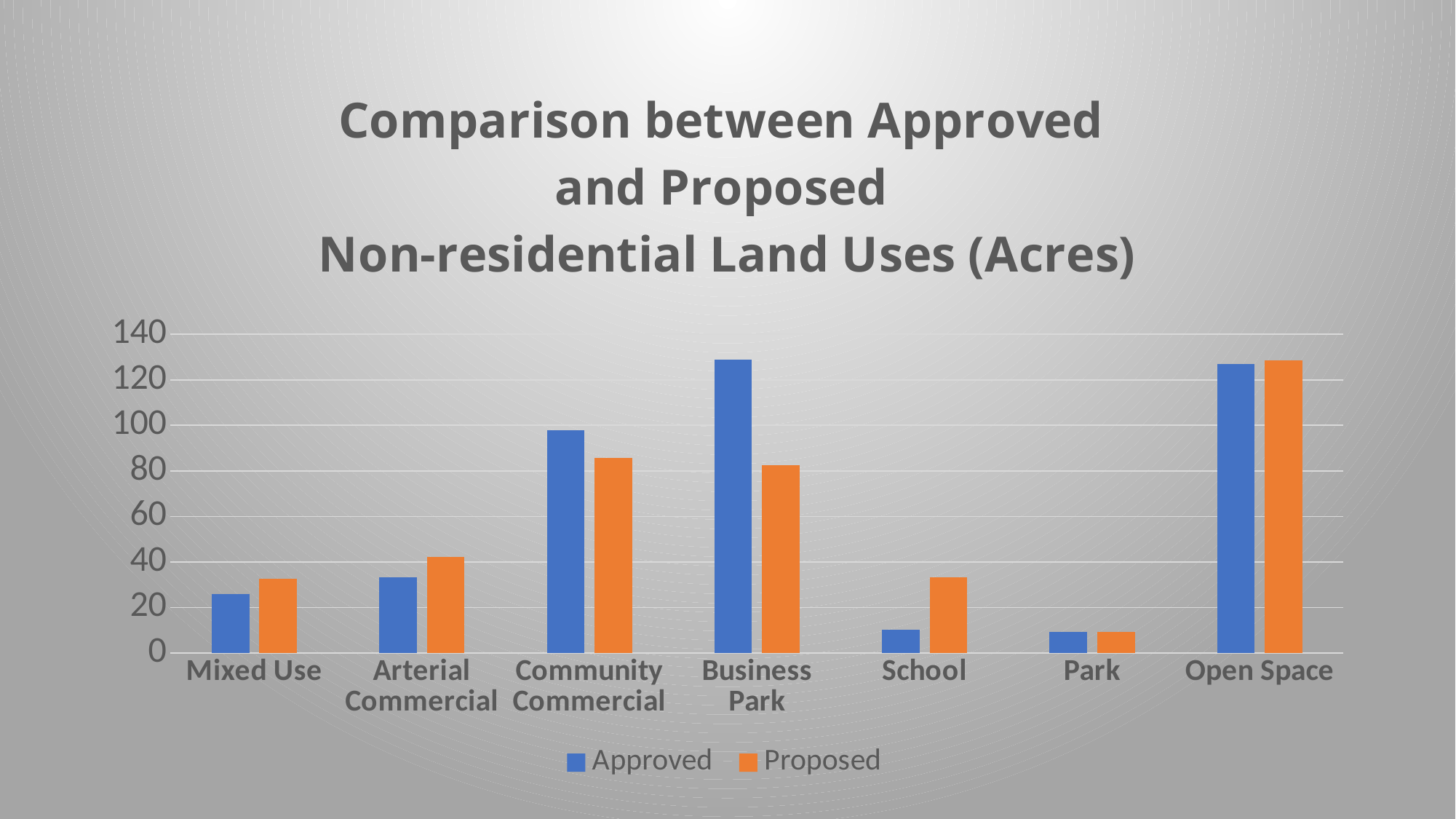
For Business Park, which is larger: the Approved value or the Proposed value? Approved How many series does the legend list? 2 Is the Proposed value for Open Space greater or less than 120? greater What kind of chart is shown on the slide? Bar chart For School, which is larger: the Approved value or the Proposed value? Proposed Is the Approved value for Business Park greater or less than 120? greater Which colour represents the Proposed series in the legend? Orange How many land use categories are shown on the x axis? 7 Which category has the lowest Proposed value? Park For Community Commercial, which is larger: the Approved value or the Proposed value? Approved Which category has the highest Proposed value? Open Space Is the Approved value for School greater or less than 20? less